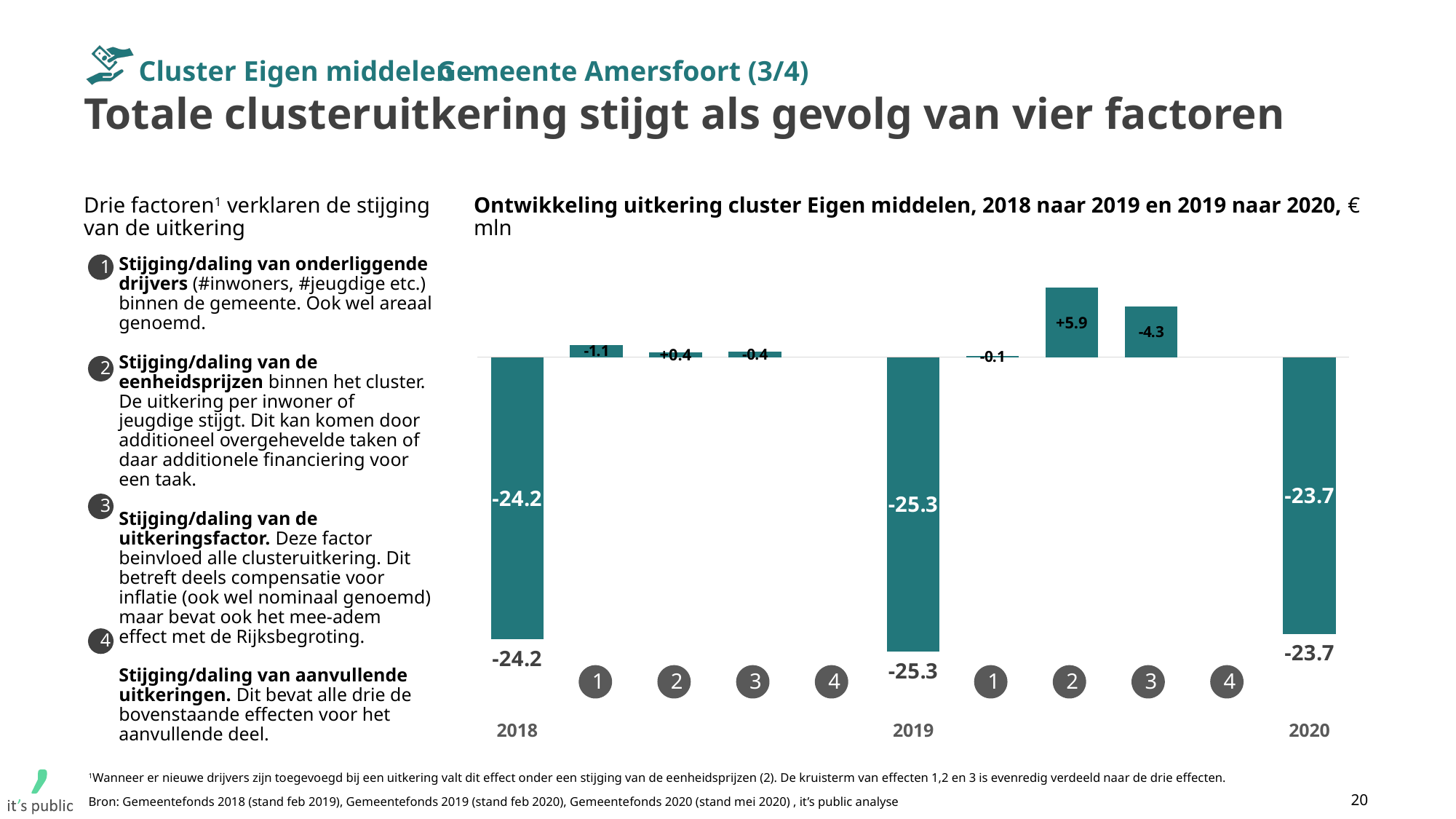
Which of the three year totals (2018, 2019, 2020) is the highest? 2020 What is the value shown for 2020 in the chart? -23.7 Which factor bar has the largest positive value in the chart? Factor 2 (2019 to 2020), +5.9 What is the value of factor 1 in the step from 2018 to 2019? -1.1 What is the value of factor 2 in the step from 2019 to 2020? +5.9 Which of the three year totals (2018, 2019, 2020) is the lowest? 2019 What is the difference between the 2019 value and the 2020 value? 1.6 What type of chart is shown on the slide? Bar chart What is the value of factor 2 in the step from 2018 to 2019? +0.4 What is the value of factor 3 in the step from 2019 to 2020? -4.3 What is the value shown for 2018 in the chart? -24.2 What is the value shown for 2019 in the chart? -25.3